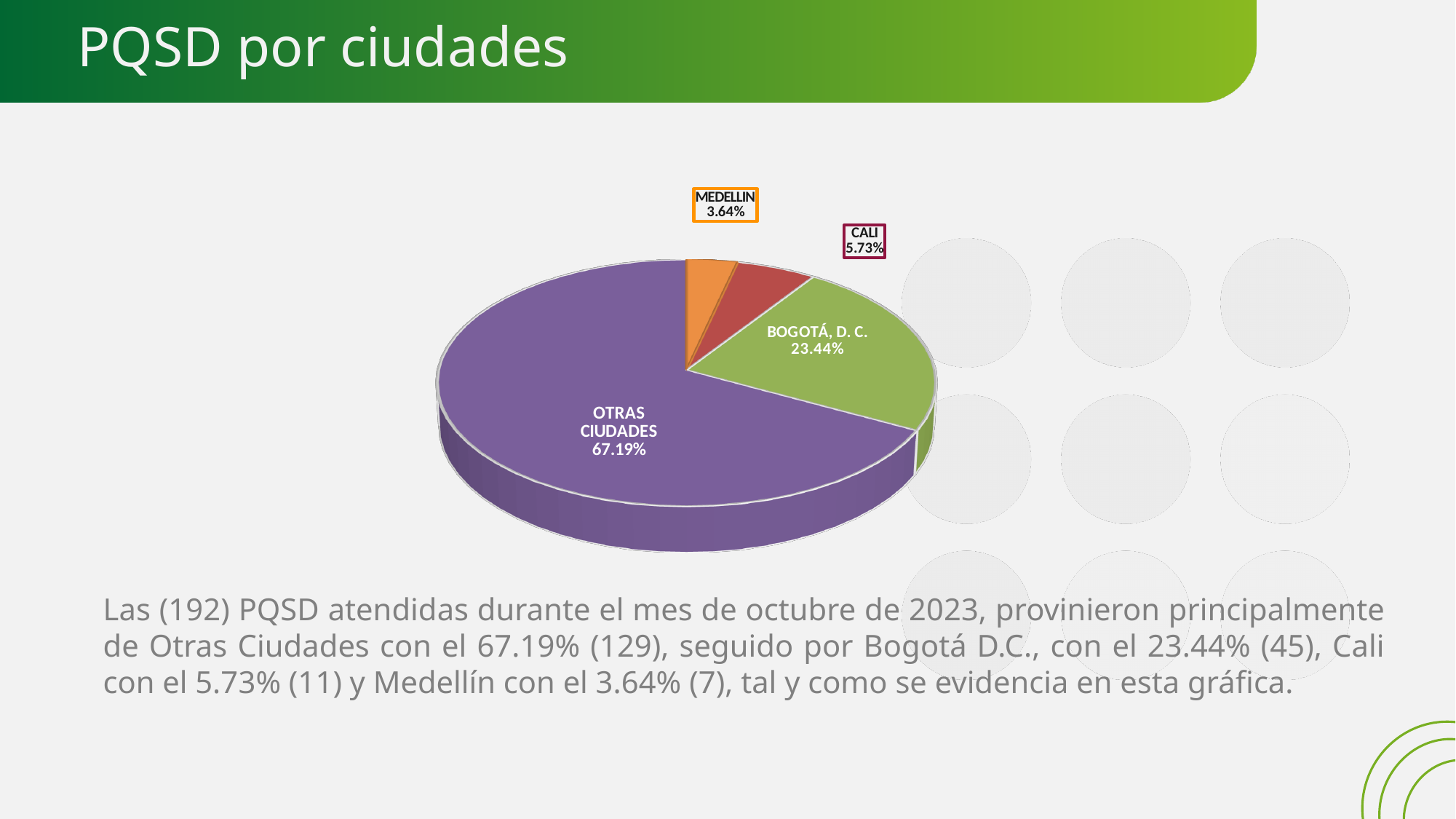
What is the difference in percentage points between OTRAS CIUDADES and BOGOTÁ, D. C.? 43.75 What is the value shown for CALI? 5.73% What is the value shown for MEDELLIN? 3.64% Which category has the smallest slice of the pie? MEDELLIN What is the difference in percentage points between CALI and MEDELLIN? 2.09 Which is larger, the slice for CALI or the slice for MEDELLIN? CALI What colour is the OTRAS CIUDADES slice? Purple What kind of chart is shown on the slide? Pie chart What share of the pie does OTRAS CIUDADES represent? 67.19% Which category has the largest slice of the pie? OTRAS CIUDADES What share of the pie does BOGOTÁ, D. C. represent? 23.44% How many categories are shown in the pie chart? 4